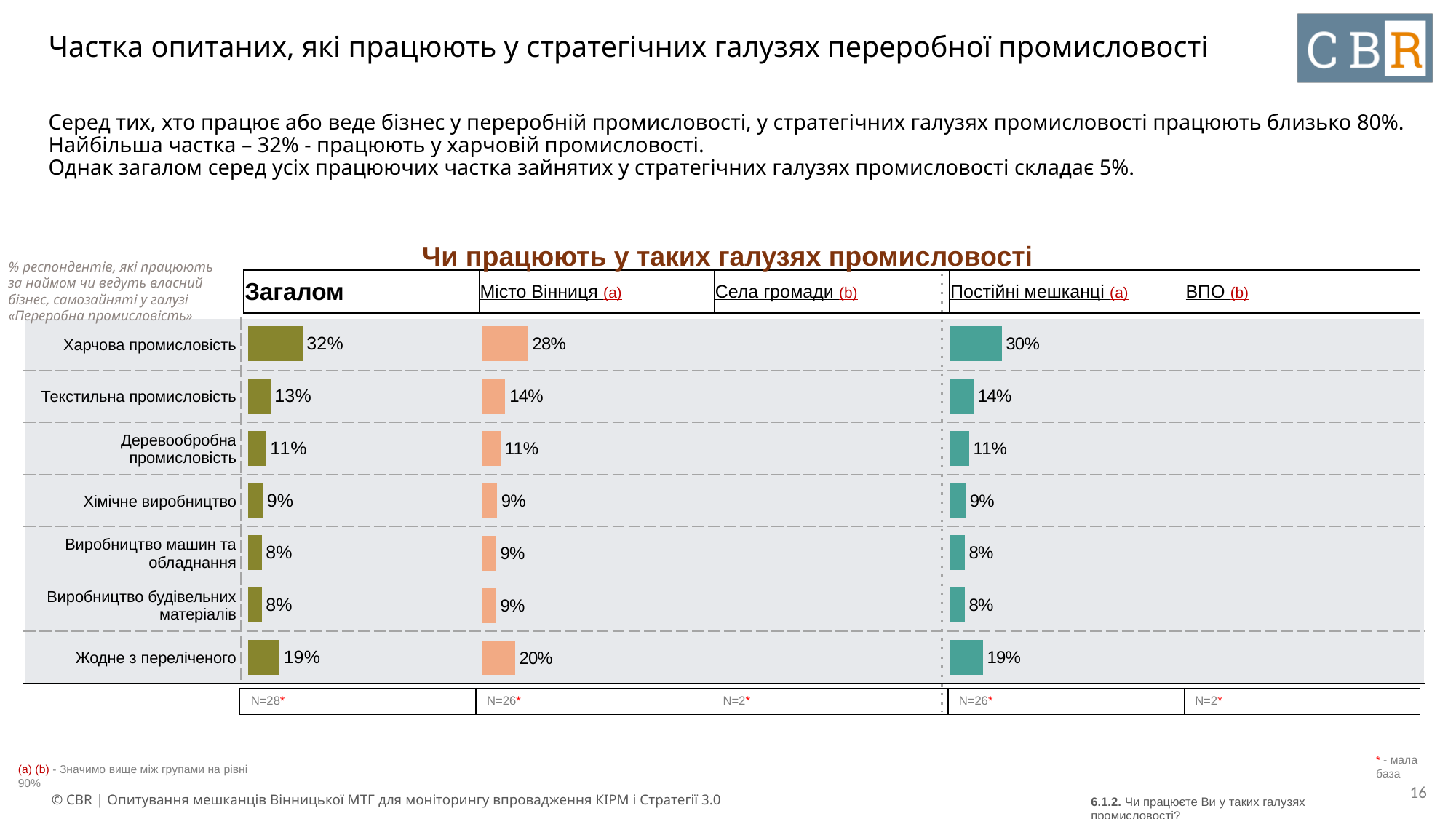
What is the title of the chart? Чи працюють у таких галузях промисловості In the 'Постійні мешканці' column, what is the value for Текстильна промисловість? 14% In the 'Загалом' column, which industry has the highest share? Харчова промисловість In the 'Постійні мешканці' column, what is the value for Деревообробна промисловість? 11% In the 'Загалом' column, what is the value for Харчова промисловість? 32% In the 'Загалом' column, what is the difference between Харчова промисловість and Текстильна промисловість? 19% How many industry categories are listed in the chart? 7 Which is larger: Харчова промисловість in 'Загалом' or Харчова промисловість in 'Місто Вінниця'? Загалом In the 'Місто Вінниця' column, what is the value for Жодне з переліченого? 20% What is the sample size (N) shown for the 'Загалом' column? N=28 What kind of chart is shown on the slide? Bar chart